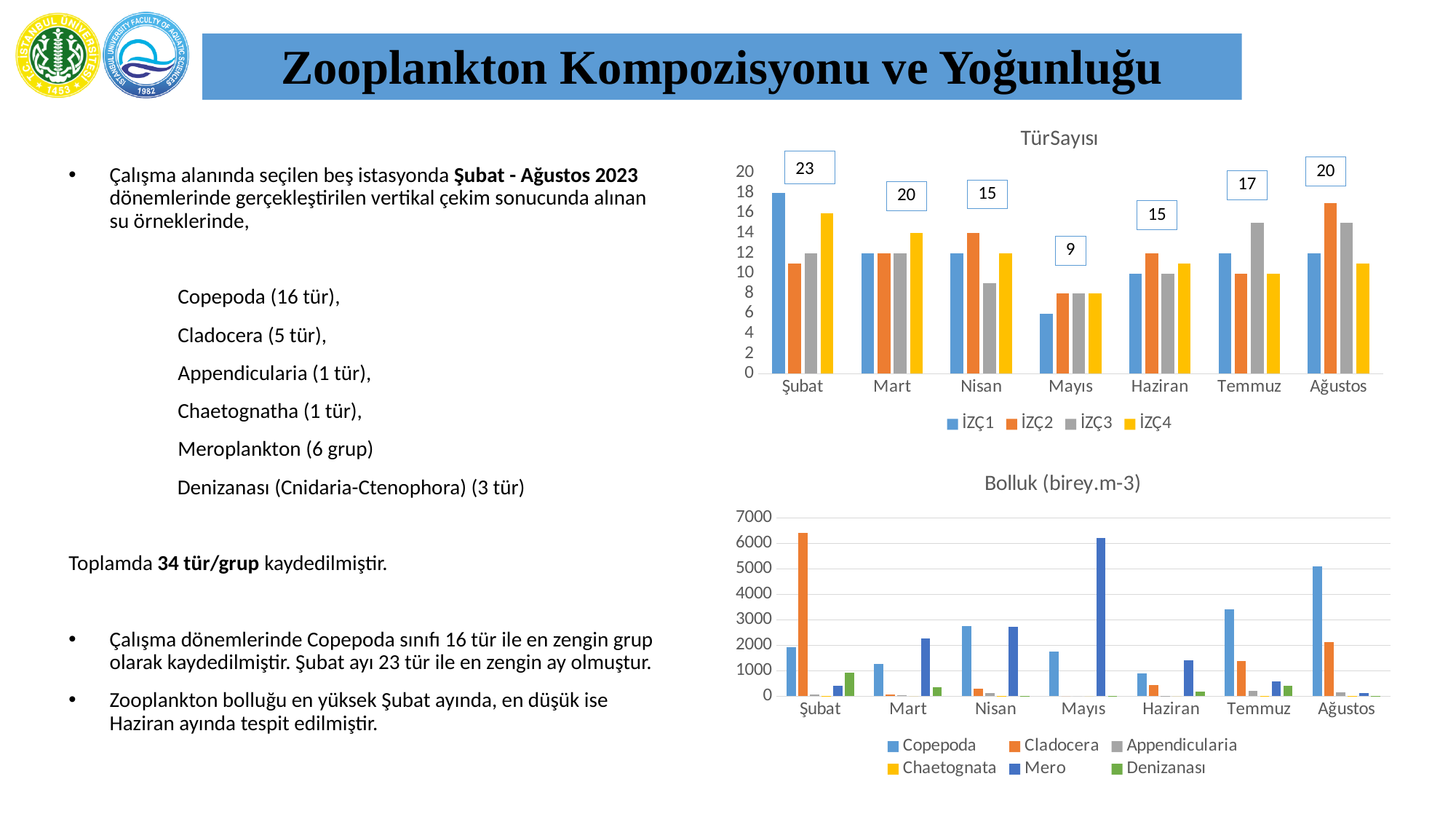
How many series does the legend of the 'Bolluk (birey.m-3)' chart list? 6 What kind of chart is the 'TürSayısı' chart? bar chart In the 'TürSayısı' chart, which month has the lowest value for İZÇ1? Mayıs In the 'TürSayısı' chart, what is the value for İZÇ1 in Şubat? 18 In the 'Bolluk (birey.m-3)' chart, is the value for Cladocera in Şubat greater or less than 6000? greater In the 'Bolluk (birey.m-3)' chart, is the value for Copepoda in Nisan greater or less than 3000? less In the 'TürSayısı' chart, what is the value for İZÇ1 in Mayıs? 6 In the 'Bolluk (birey.m-3)' chart, which series has the highest value in Mayıs? Mero In the 'TürSayısı' chart, what number is shown in the box above the Şubat bars? 23 In the 'TürSayısı' chart, which station has the highest value in Ağustos? İZÇ2 In the 'TürSayısı' chart, what is the value for İZÇ4 in Mart? 14 How many months are shown on the x axis of the 'TürSayısı' chart? 7